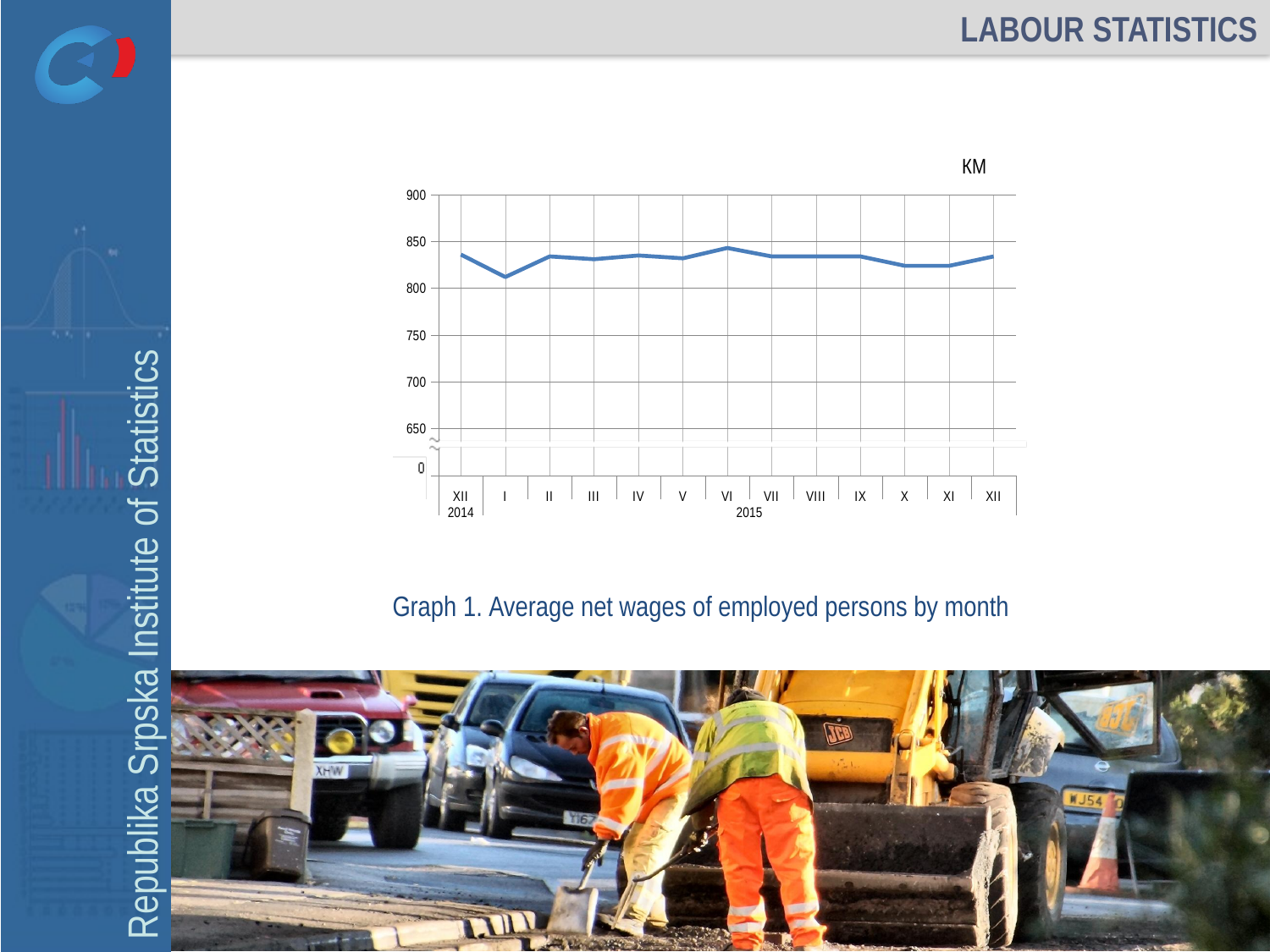
Which is larger, the value for I 2015 or the value for VI 2015? VI 2015 Which month has the highest average net wage on the chart? VI 2015 What unit is shown above the chart's y axis? KM What kind of chart is Graph 1? line chart Is the value for XII 2014 greater or less than 800? greater What is the title of the graph? Graph 1. Average net wages of employed persons by month How many monthly data points are plotted on the chart? 13 Is the value for I 2015 greater or less than 800? greater Is the value for X 2015 greater or less than 850? less Which month has the lowest average net wage on the chart? I 2015 Does the value rise or fall from XII 2014 to I 2015? fall